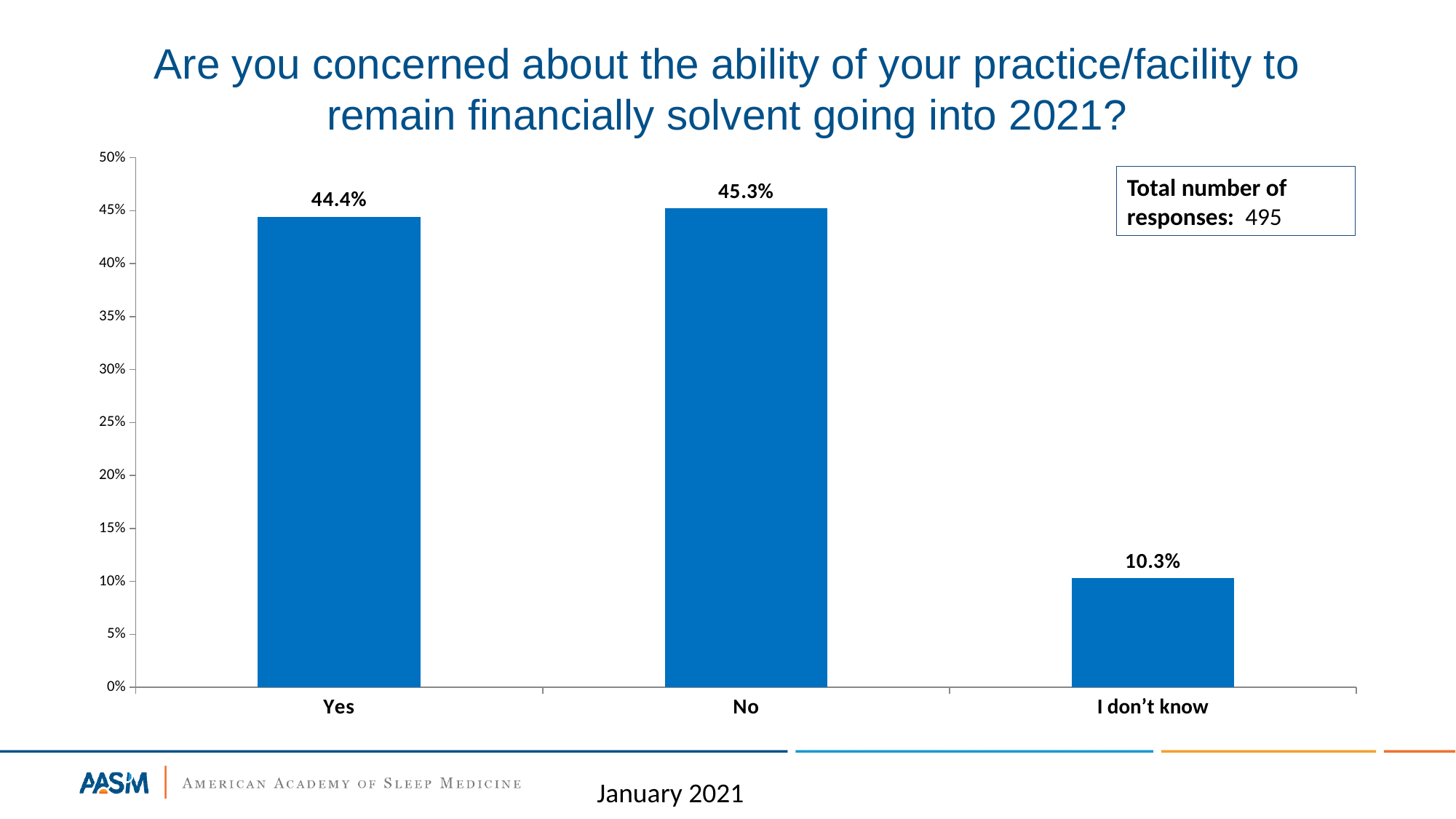
Is the value for "I don't know" greater or less than 15%? less Which response category has the highest percentage? No What is the difference in percentage points between the "No" and "Yes" responses? 0.9 percentage points What kind of chart is shown on the slide? Bar chart What percentage of respondents answered "I don't know"? 10.3% How many response categories are shown on the x axis? 3 What is the difference in percentage points between the "Yes" and "I don't know" responses? 34.1 percentage points Which is larger, the percentage for "Yes" or for "I don't know"? Yes What is the total number of responses stated on the slide? 495 Which response category has the lowest percentage? I don't know What percentage of respondents answered "No"? 45.3% What percentage of respondents answered "Yes"? 44.4%